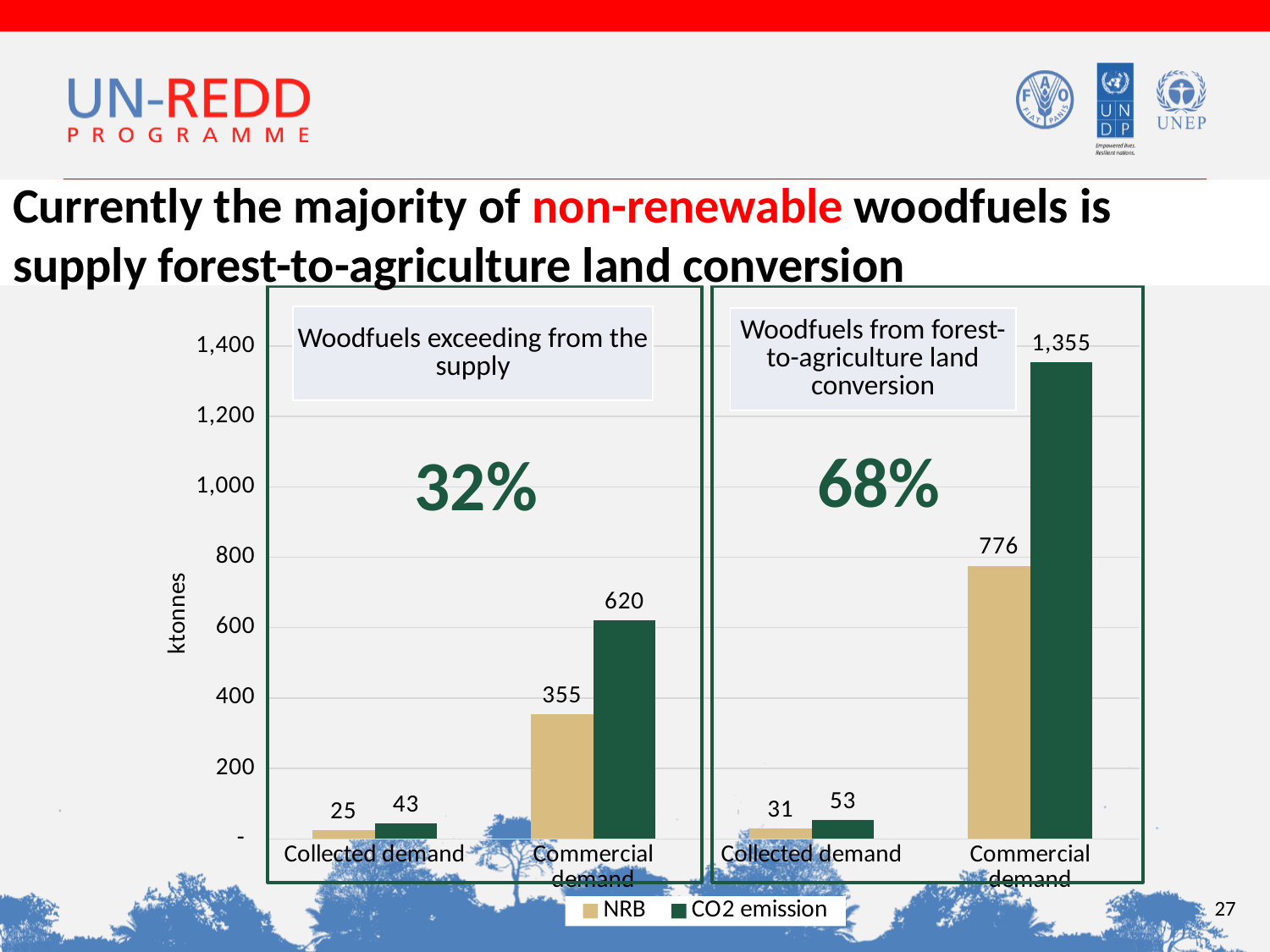
In the 'Woodfuels from forest-to-agriculture land conversion' panel, what is the NRB value for Commercial demand? 776 In the 'Woodfuels exceeding from the supply' panel, what is the difference between the CO2 emission and NRB values for Commercial demand? 265 What unit is shown on the vertical axis of the chart? ktonnes What type of chart is shown on the slide? Bar chart In the 'Woodfuels exceeding from the supply' panel, what is the CO2 emission value for Commercial demand? 620 In the 'Woodfuels exceeding from the supply' panel, what is the NRB value for Collected demand? 25 What is the difference between the Commercial demand CO2 emission values of the two panels (1,355 vs 620)? 735 Across both panels, which bar has the lowest value? NRB for Collected demand in the 'Woodfuels exceeding from the supply' panel (25) How many series does the legend list? 2 Across both panels, which bar has the highest value? CO2 emission for Commercial demand in the forest-to-agriculture land conversion panel (1,355) In the 'Woodfuels from forest-to-agriculture land conversion' panel, what is the CO2 emission value for Collected demand? 53 Which is larger: the NRB value for Commercial demand in the 'Woodfuels exceeding from the supply' panel or in the 'Woodfuels from forest-to-agriculture land conversion' panel? Woodfuels from forest-to-agriculture land conversion (776)